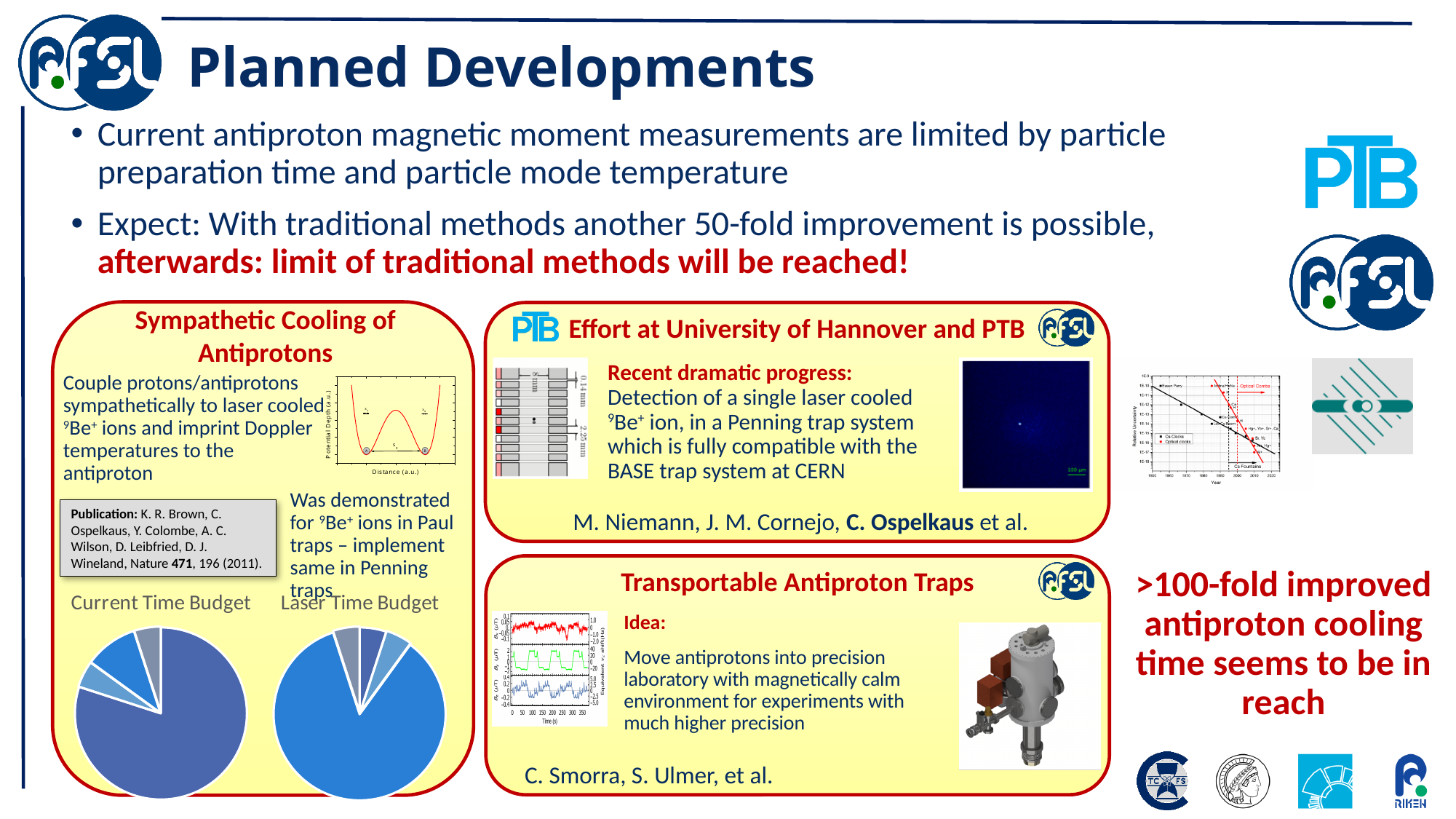
How many pie charts are shown on the slide? 2 What is the title of the left pie chart on the slide? Current Time Budget In the "Laser Time Budget" pie chart, which colour slice is the largest? blue How many slices does the "Laser Time Budget" pie chart have? 4 What kind of chart is the "Current Time Budget" chart? pie chart How many slices does the "Current Time Budget" pie chart have? 4 What is the title of the right pie chart on the slide? Laser Time Budget What kind of chart is the "Laser Time Budget" chart? pie chart In the "Current Time Budget" pie chart, which colour slice is the largest? dark blue